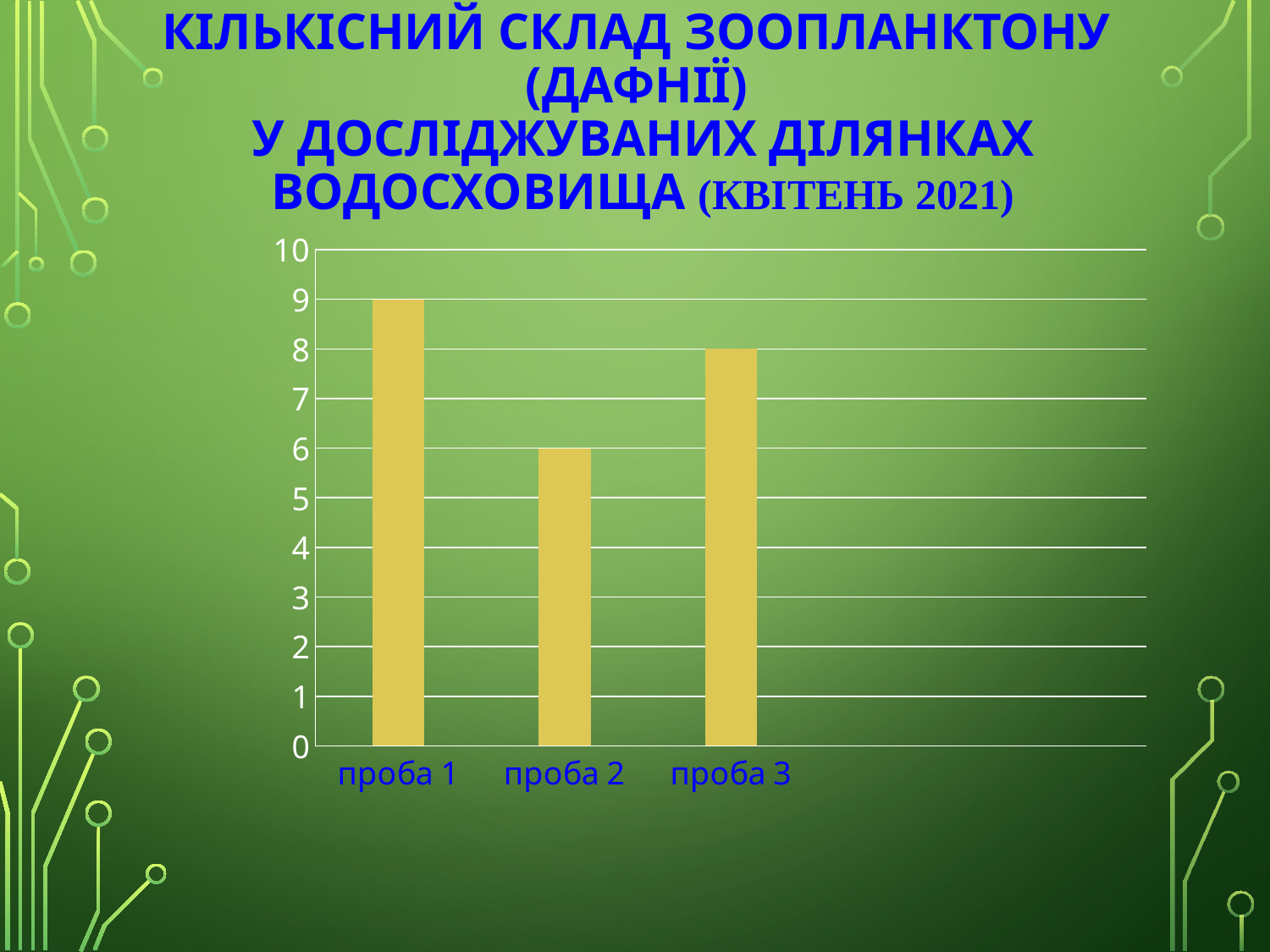
What is the value for проба 3? 8 What is the value for проба 2? 6 Which category has the highest value? проба 1 What is the difference between the values for проба 1 and проба 2? 3 What is the value for проба 1? 9 What is the difference between the values for проба 3 and проба 2? 2 What kind of chart is shown on the slide? bar chart Which category has the lowest value? проба 2 Is the value for проба 2 greater or less than 7? less Which is larger, the value for проба 1 or the value for проба 3? проба 1 How many categories are shown on the x axis? 3 What is the highest value shown on the vertical axis? 10